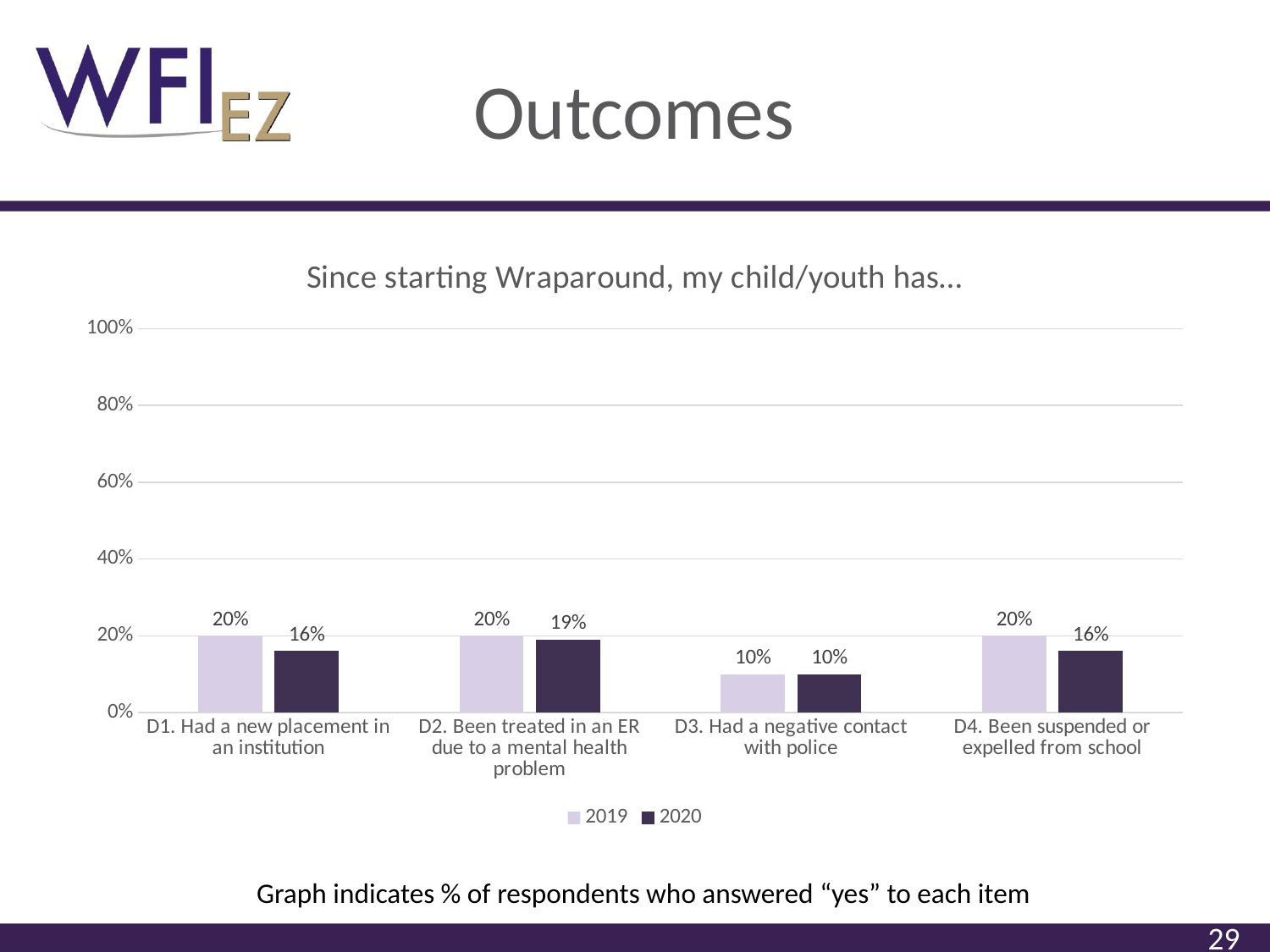
What is the 2020 value for D4. Been suspended or expelled from school? 16% How many series does the legend list? 2 How many categories are shown on the x axis? 4 What is the title of the chart? Since starting Wraparound, my child/youth has… What is the difference between the 2019 and 2020 values for D1. Had a new placement in an institution? 4% What is the 2019 value for D1. Had a new placement in an institution? 20% What is the difference between the 2019 and 2020 values for D2. Been treated in an ER due to a mental health problem? 1% What is the 2020 value for D2. Been treated in an ER due to a mental health problem? 19% Which category has the lowest 2020 value? D3. Had a negative contact with police Which is larger for D4. Been suspended or expelled from school, the 2019 value or the 2020 value? 2019 Is the 2019 value for D3. Had a negative contact with police greater or less than 20%? less What kind of chart is shown on the slide? bar chart